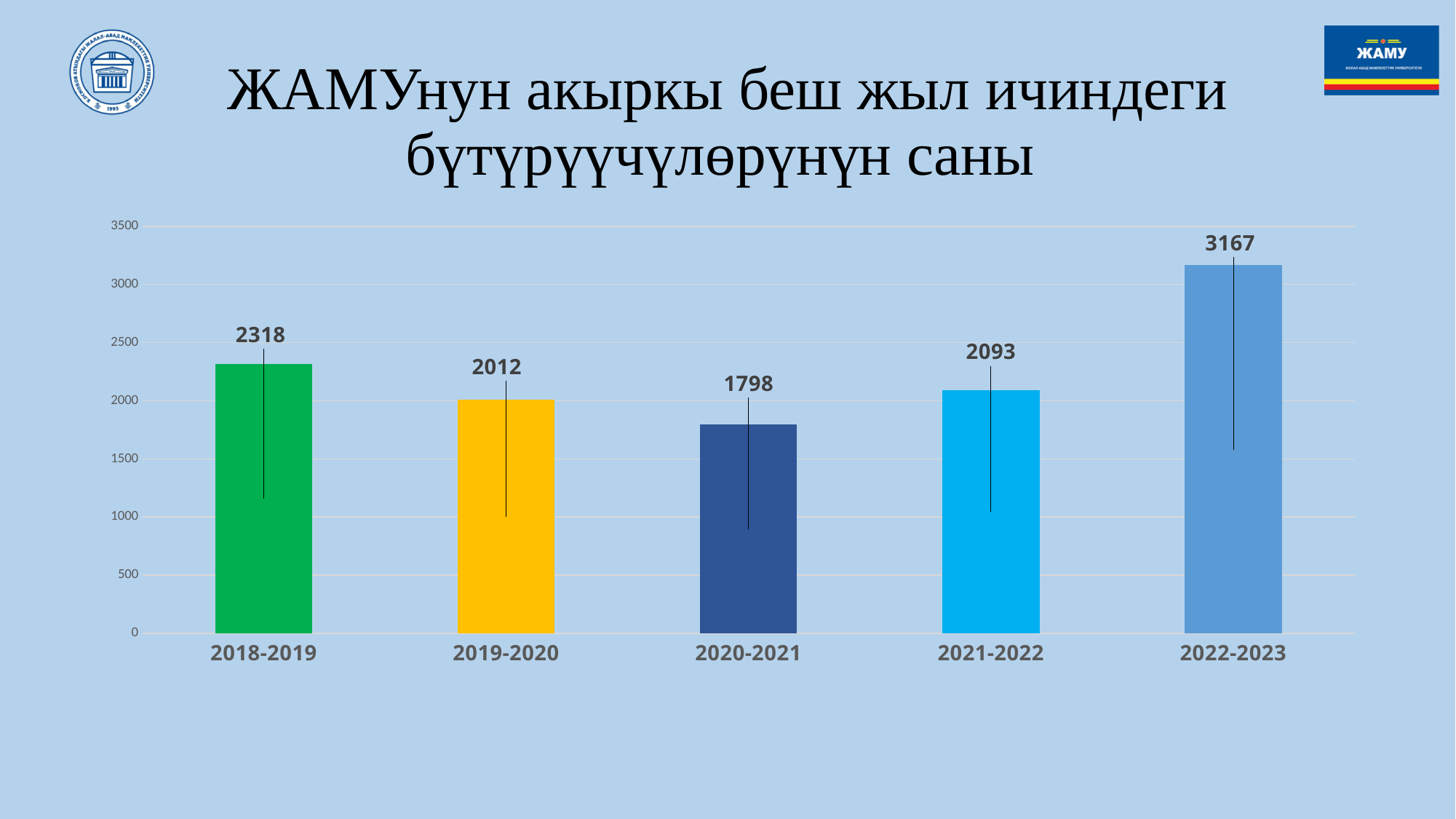
What is the value for 2018-2019? 2318 What kind of chart is shown on the slide? bar chart How many academic years are shown on the chart? 5 Is the value for 2022-2023 greater or less than 3000? greater What is the value for 2020-2021? 1798 What is the difference between the values for 2022-2023 and 2021-2022? 1074 Which academic year has the lowest value? 2020-2021 Which academic year has the highest value? 2022-2023 What is the value for 2022-2023? 3167 Which is larger, the value for 2019-2020 or the value for 2021-2022? 2021-2022 What colour is the bar for 2019-2020? yellow What is the difference between the values for 2018-2019 and 2019-2020? 306